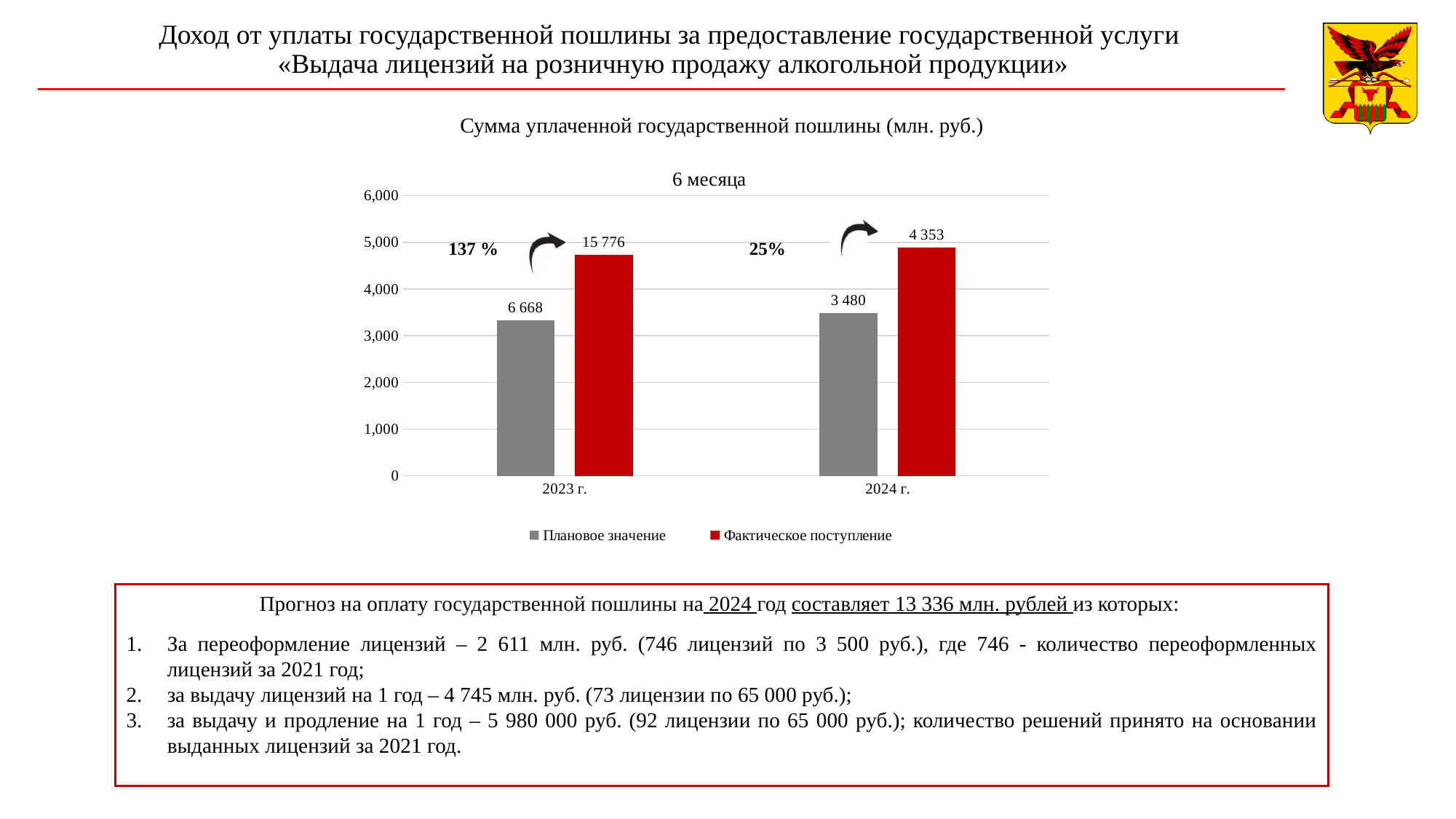
How many series does the chart legend list? 2 What is the Плановое значение for 2023 г.? 6 668 In 2023 г., which is larger: Плановое значение or Фактическое поступление? Фактическое поступление How many year categories are shown on the x axis of the chart? 2 What kind of chart is shown on the slide? Bar chart What is the Плановое значение for 2024 г.? 3 480 What is the Фактическое поступление for 2023 г.? 15 776 What is the difference between Фактическое поступление and Плановое значение for 2024 г.? 873 What is the difference between Фактическое поступление and Плановое значение for 2023 г.? 9 108 In 2024 г., which is larger: Плановое значение or Фактическое поступление? Фактическое поступление What is the Фактическое поступление for 2024 г.? 4 353 What percentage is printed above the 2023 г. bars in the chart? 137 %